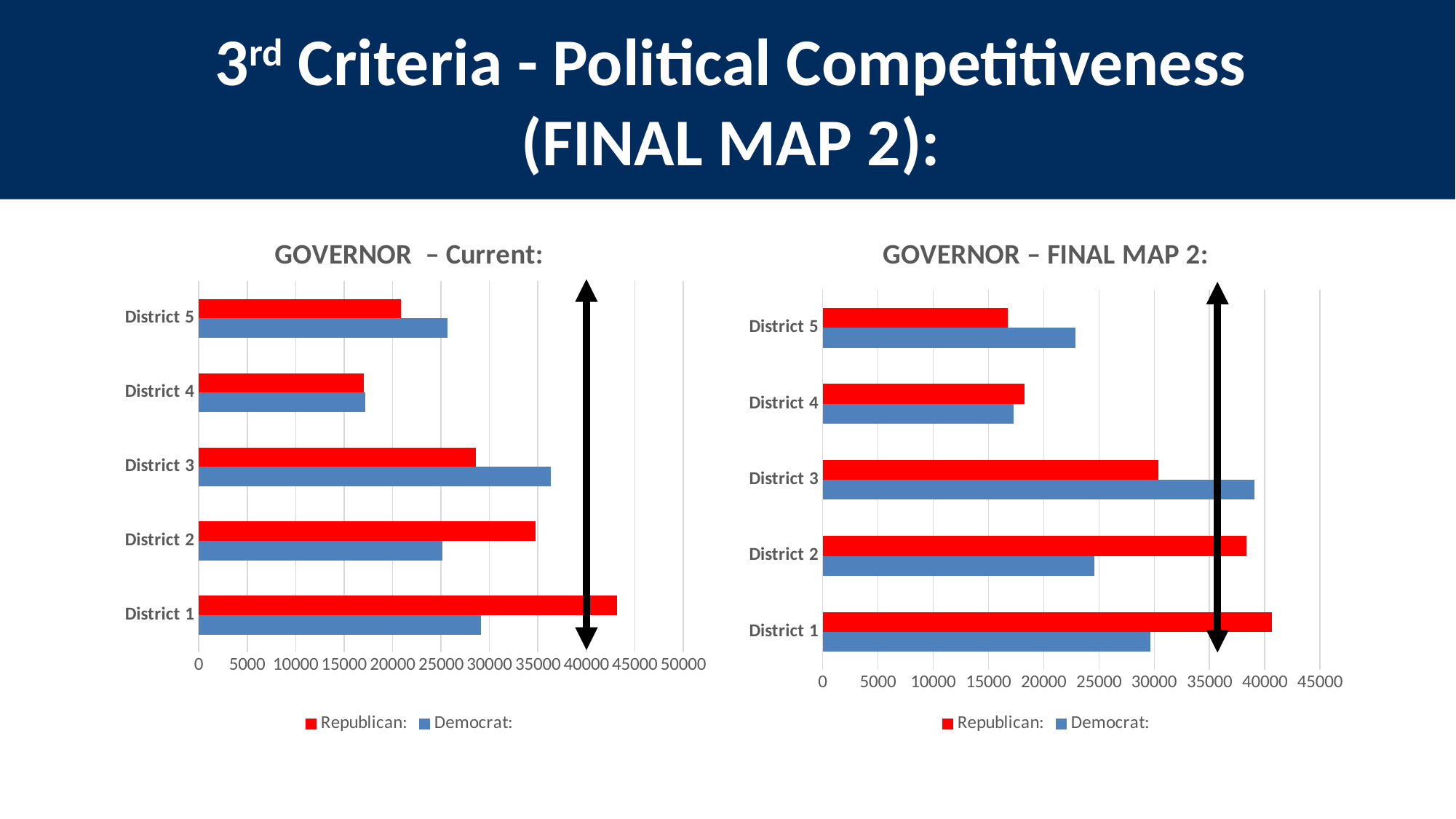
In the GOVERNOR – FINAL MAP 2 chart, which district has the highest Democrat value? District 3 In the GOVERNOR – Current chart, how many series does the legend list? 2 What are the two legend entries in the GOVERNOR – FINAL MAP 2 chart? Republican and Democrat In the GOVERNOR – Current chart, how many districts are shown? 5 In the GOVERNOR – Current chart, is the Democrat value for District 3 greater or less than 35000? greater In the GOVERNOR – Current chart, is the Republican value for District 1 greater or less than 40000? greater In the GOVERNOR – FINAL MAP 2 chart, is the Democrat value for District 1 greater or less than 25000? greater In the GOVERNOR – Current chart, which district has the highest Republican value? District 1 In the GOVERNOR – Current chart, which is larger for District 2, the Republican or the Democrat value? Republican What kind of chart is the GOVERNOR – Current chart? bar chart In the GOVERNOR – FINAL MAP 2 chart, which is larger for District 3, the Republican or the Democrat value? Democrat